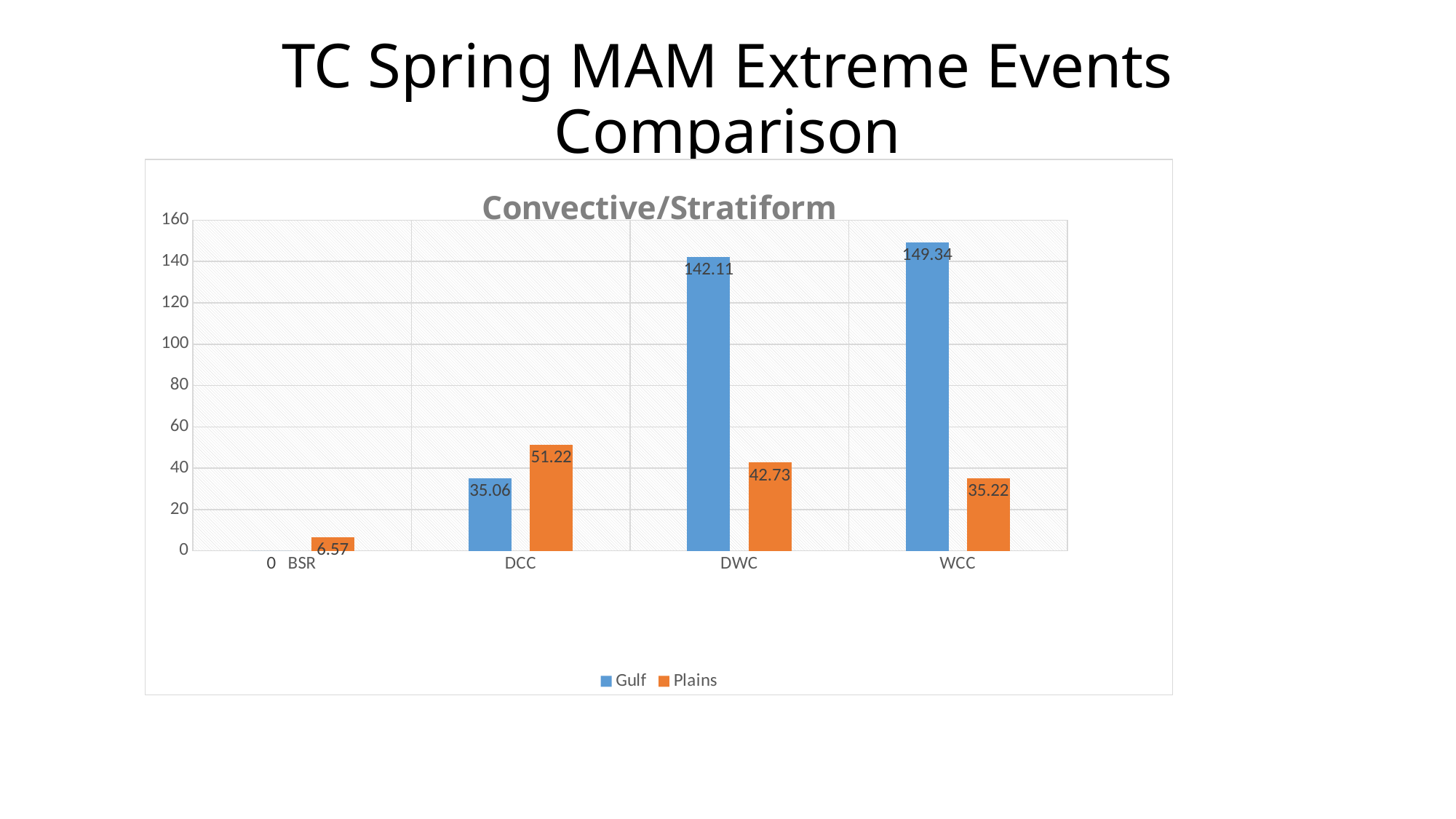
What is the Gulf value for BSR? 0 How many series does the legend list? 2 What is the Plains value for DCC? 51.22 How many categories are shown on the x axis? 4 What kind of chart is shown? Bar chart What is the Plains value for WCC? 35.22 What is the Gulf value for DWC? 142.11 What is the title of the chart? Convective/Stratiform What is the difference between the Gulf and Plains values for DWC? 99.38 Which is larger for DCC, the Gulf value or the Plains value? Plains Which category has the lowest Plains value? BSR Which category has the highest Gulf value? WCC